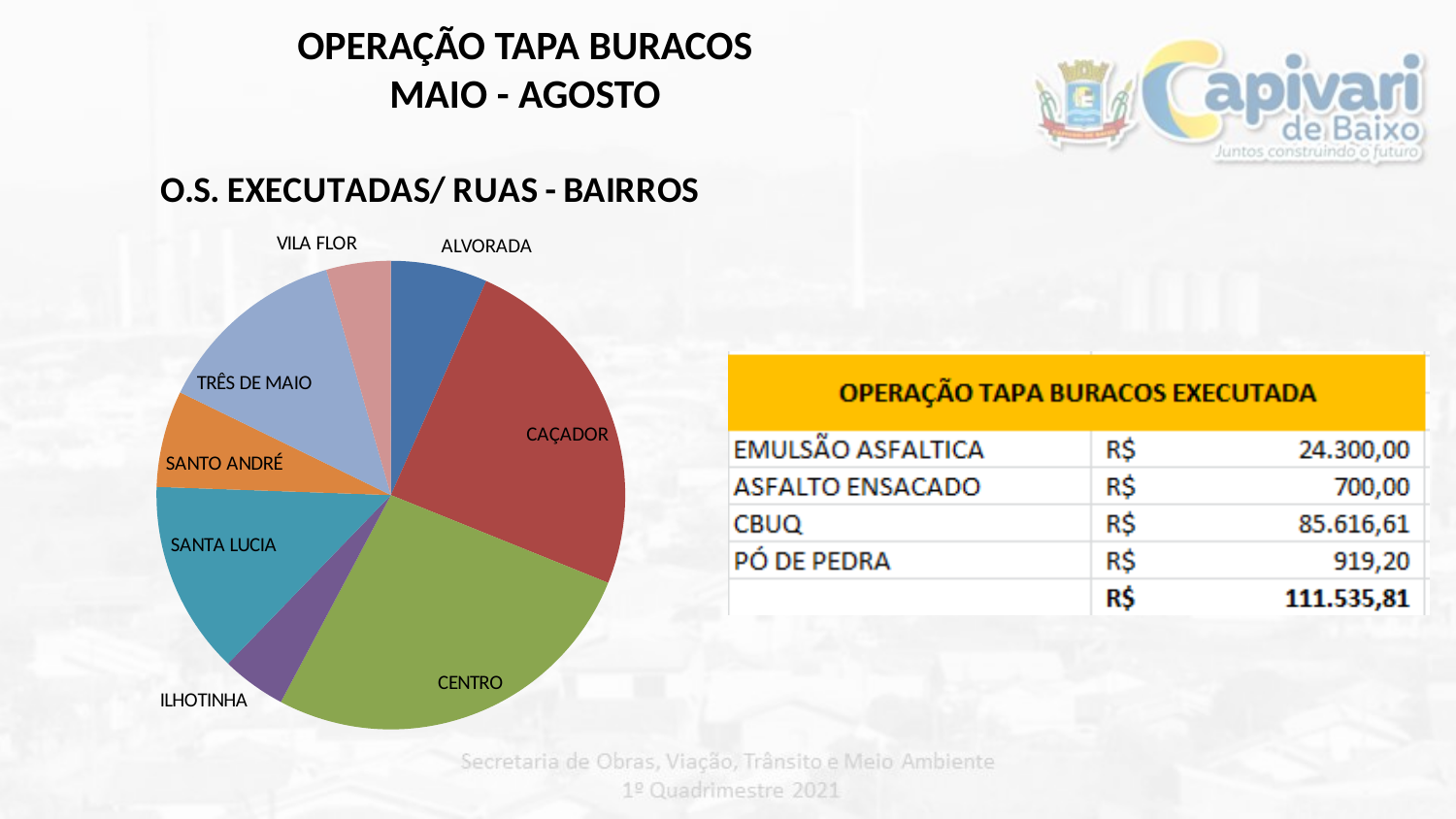
What kind of chart is shown on the slide? pie chart Which slice is larger in the pie chart, TRÊS DE MAIO or ILHOTINHA? TRÊS DE MAIO How many slices (neighbourhoods) does the pie chart have? 8 Which slice is larger in the pie chart, SANTA LUCIA or SANTO ANDRÉ? SANTA LUCIA Which slice is larger in the pie chart, CAÇADOR or VILA FLOR? CAÇADOR What is the heading shown above the pie chart? O.S. EXECUTADAS/ RUAS - BAIRROS What colour is the CENTRO slice in the pie chart? green Which neighbourhood has the largest slice in the pie chart? CENTRO